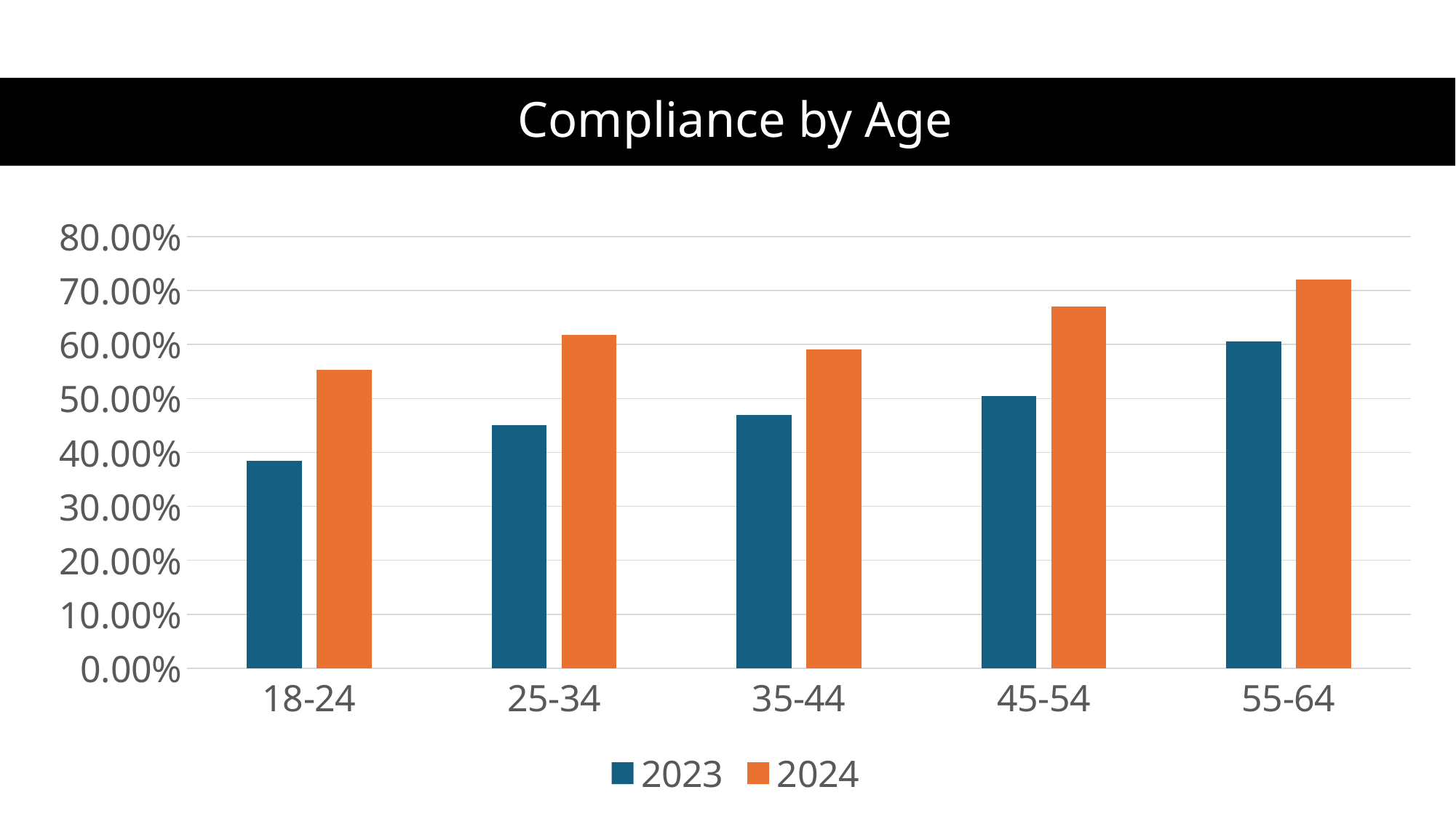
How many series does the legend list? 2 Do the 2023 values rise or fall as the age groups move from 18-24 to 55-64? Rise Is the 2024 value for 45-54 greater or less than 60.00%? greater Is the 2024 value for 55-64 greater or less than 70.00%? greater For the 35-44 age group, which is larger, the 2023 value or the 2024 value? 2024 What kind of chart is shown on the slide? Bar chart Is the 2023 value for 18-24 greater or less than 40.00%? less What is the title of the chart? Compliance by Age Which age group has the lowest value for 2024? 18-24 Which age group has the lowest value for 2023? 18-24 Which age group has the highest value for 2024? 55-64 How many age groups are shown on the x axis? 5